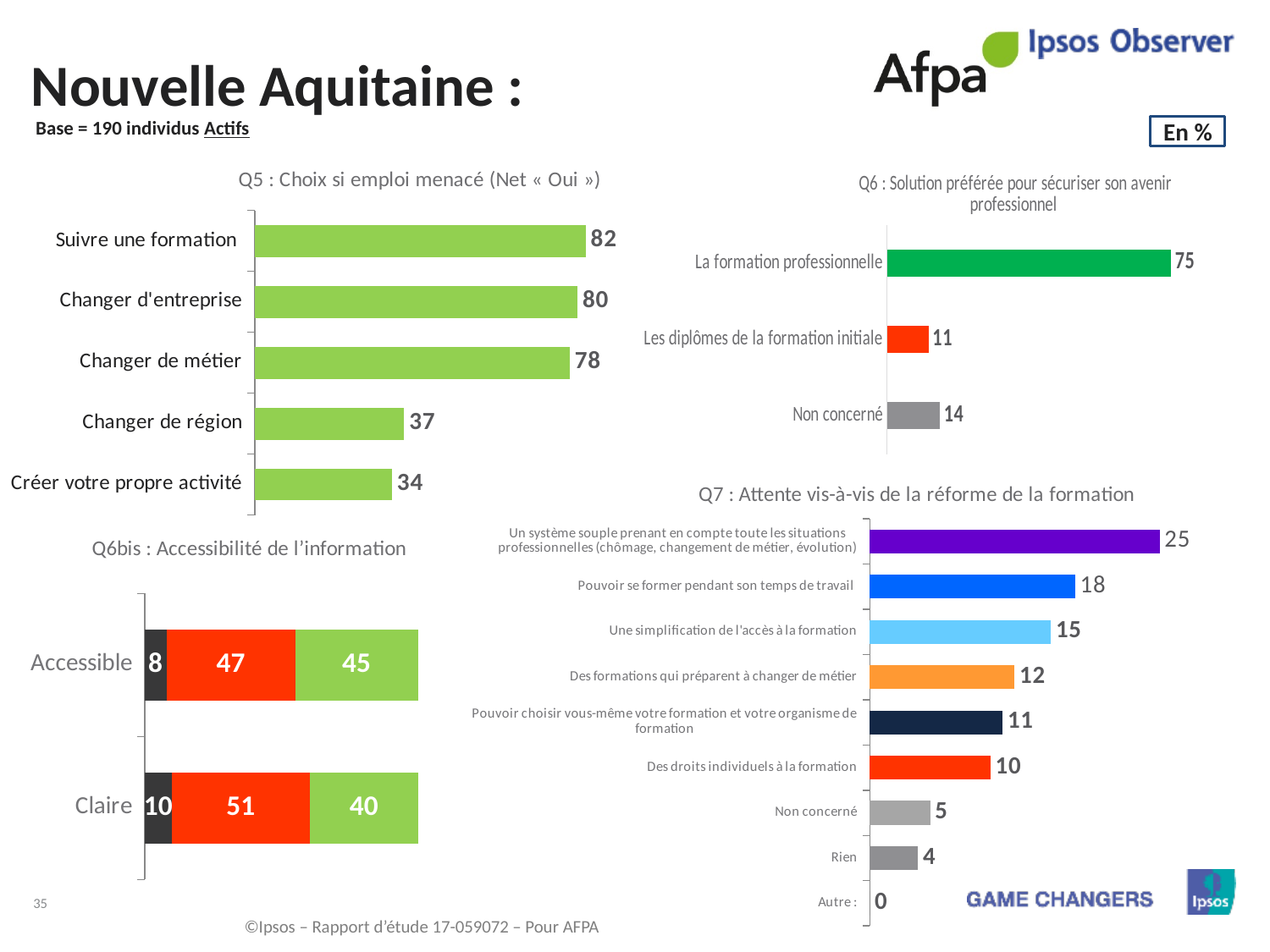
In the Q6 chart (Solution préférée pour sécuriser son avenir professionnel), which is larger: "Les diplômes de la formation initiale" or "Non concerné"? Non concerné In the Q5 chart (Choix si emploi menacé), which category has the lowest value? Créer votre propre activité In the Q7 chart (Attente vis-à-vis de la réforme de la formation), what is the value for "Pouvoir se former pendant son temps de travail"? 18 How many categories are shown in the Q6 chart (Solution préférée pour sécuriser son avenir professionnel)? 3 In the Q5 chart (Choix si emploi menacé), what is the difference between "Suivre une formation" and "Créer votre propre activité"? 48 In the Q5 chart (Choix si emploi menacé), what is the value for "Changer de région"? 37 What type of chart is the Q7 chart (Attente vis-à-vis de la réforme de la formation)? Bar chart In the Q7 chart (Attente vis-à-vis de la réforme de la formation), how many categories are listed? 9 In the Q6 chart (Solution préférée pour sécuriser son avenir professionnel), what is the value for "La formation professionnelle"? 75 In the Q5 chart (Choix si emploi menacé), which category has the highest value? Suivre une formation In the Q6bis chart (Accessibilité de l'information), what is the total of the "Accessible" stacked bar? 100 In the Q6bis chart (Accessibilité de l'information), what is the value of the middle (red) segment of the "Claire" bar? 51